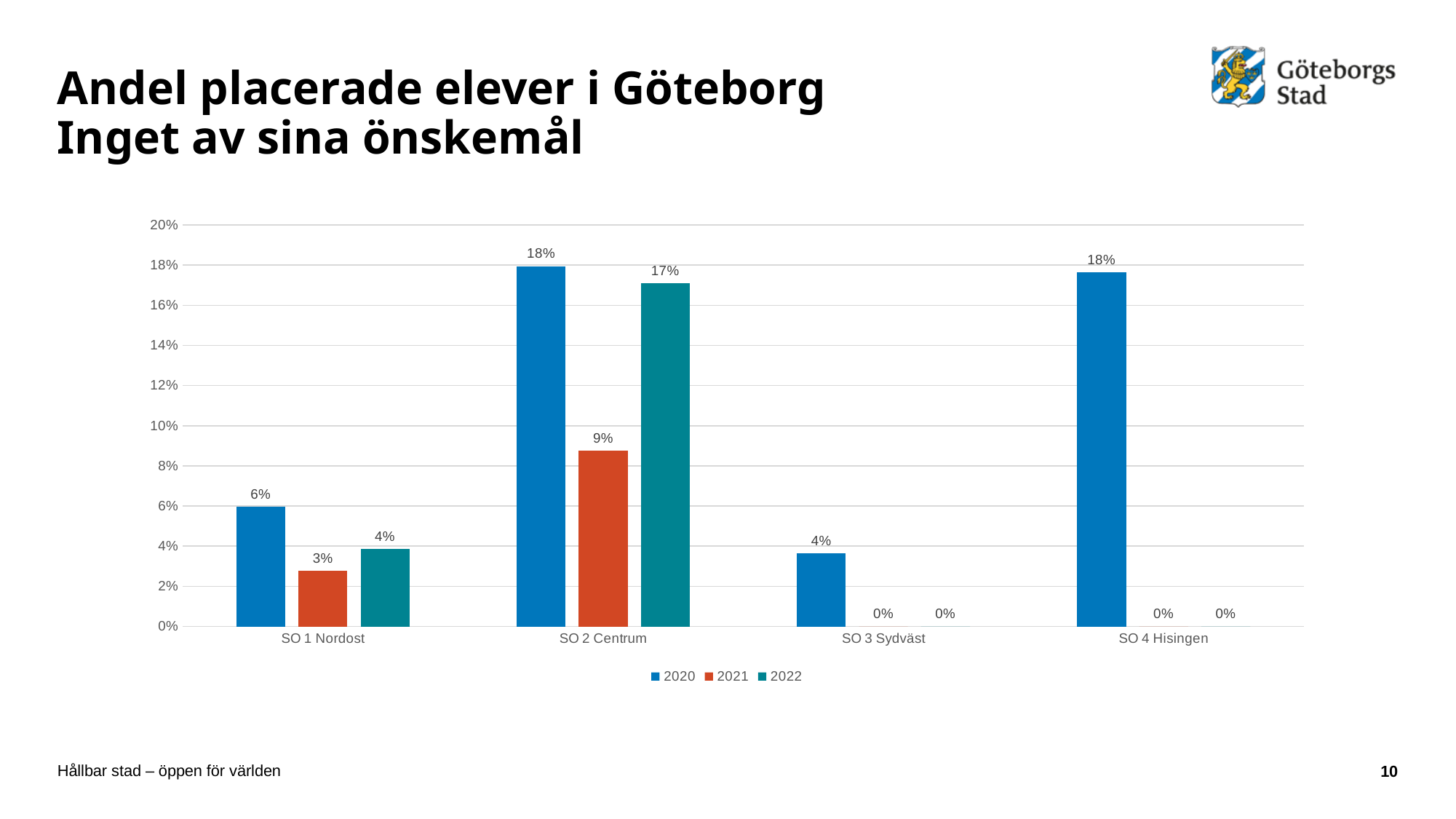
What is the value for 2020 in SO 3 Sydväst? 4% What kind of chart is shown on the slide? Bar chart Which category has the lowest value for the 2020 series? SO 3 Sydväst How many categories are shown on the x axis? 4 Which category has the highest value for the 2022 series? SO 2 Centrum What is the value for 2021 in SO 4 Hisingen? 0% How many series does the legend list? 3 What is the difference between the 2020 and 2021 values in SO 2 Centrum? 9 percentage points What is the value for 2021 in SO 2 Centrum? 9% Which is larger in SO 1 Nordost: the 2020 value or the 2021 value? 2020 Is the 2022 value for SO 2 Centrum greater or less than 10%? greater What is the value for 2022 in SO 1 Nordost? 4%